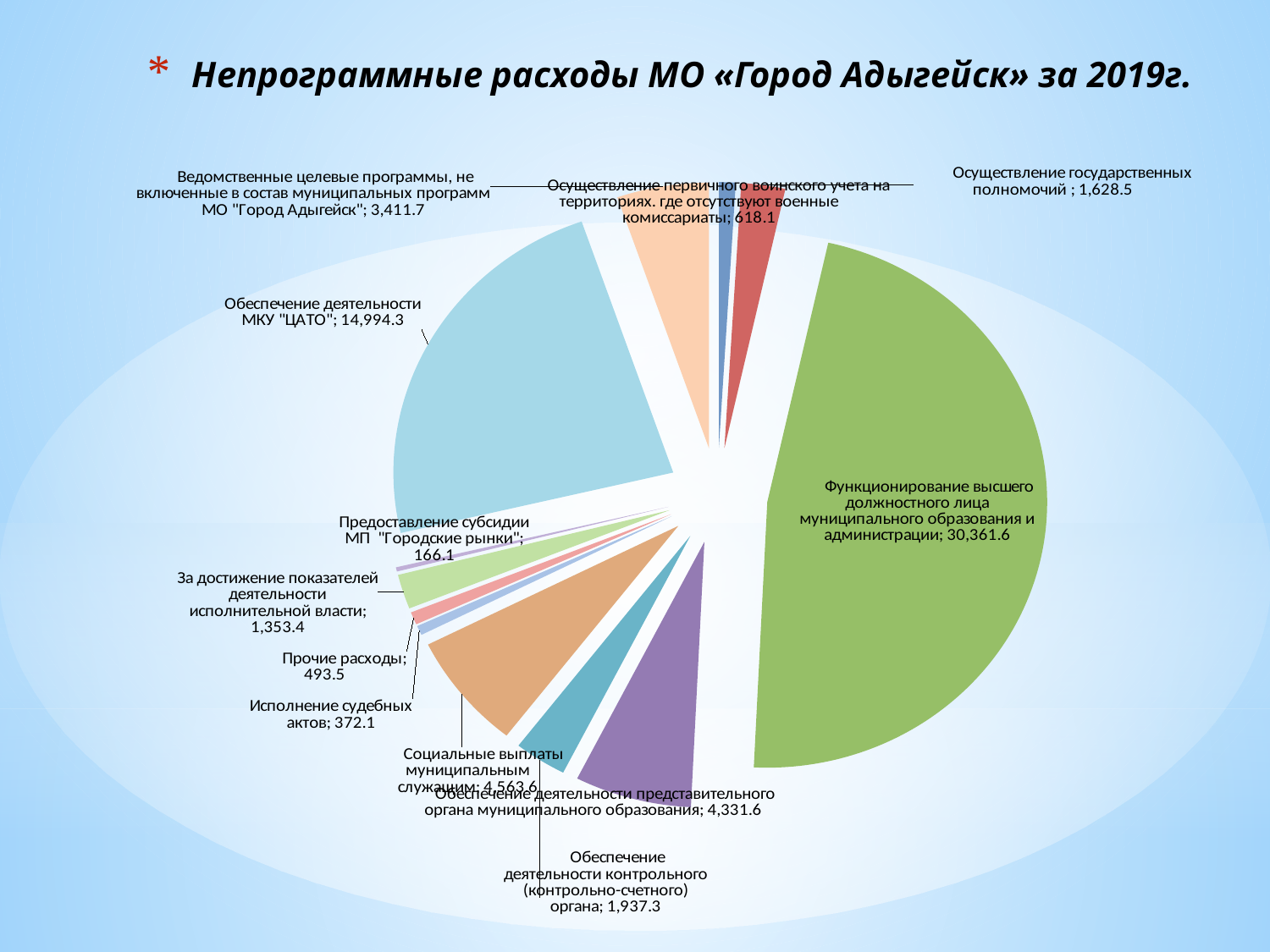
What is the value for Обеспечение деятельности контрольного (контрольно-счетного) органа? 1,937.3 Which category has the smallest slice of the pie? Предоставление субсидии МП "Городские рынки" What is the value for Осуществление государственных полномочий? 1,628.5 What is the value for Прочие расходы? 493.5 What is the title of the chart on the slide? Непрограммные расходы МО «Город Адыгейск» за 2019г. Which is larger: Ведомственные целевые программы, не включенные в состав муниципальных программ МО "Город Адыгейск" or За достижение показателей деятельности исполнительной власти? Ведомственные целевые программы, не включенные в состав муниципальных программ МО "Город Адыгейск" What kind of chart is shown on the slide? pie chart How many categories (slices) does the pie chart have? 12 Which category has the largest slice of the pie? Функционирование высшего должностного лица муниципального образования и администрации What is the difference between the value for Функционирование высшего должностного лица муниципального образования и администрации and the value for Обеспечение деятельности МКУ "ЦАТО"? 15,367.3 What is the value for Обеспечение деятельности МКУ "ЦАТО"? 14,994.3 What is the value for Исполнение судебных актов? 372.1